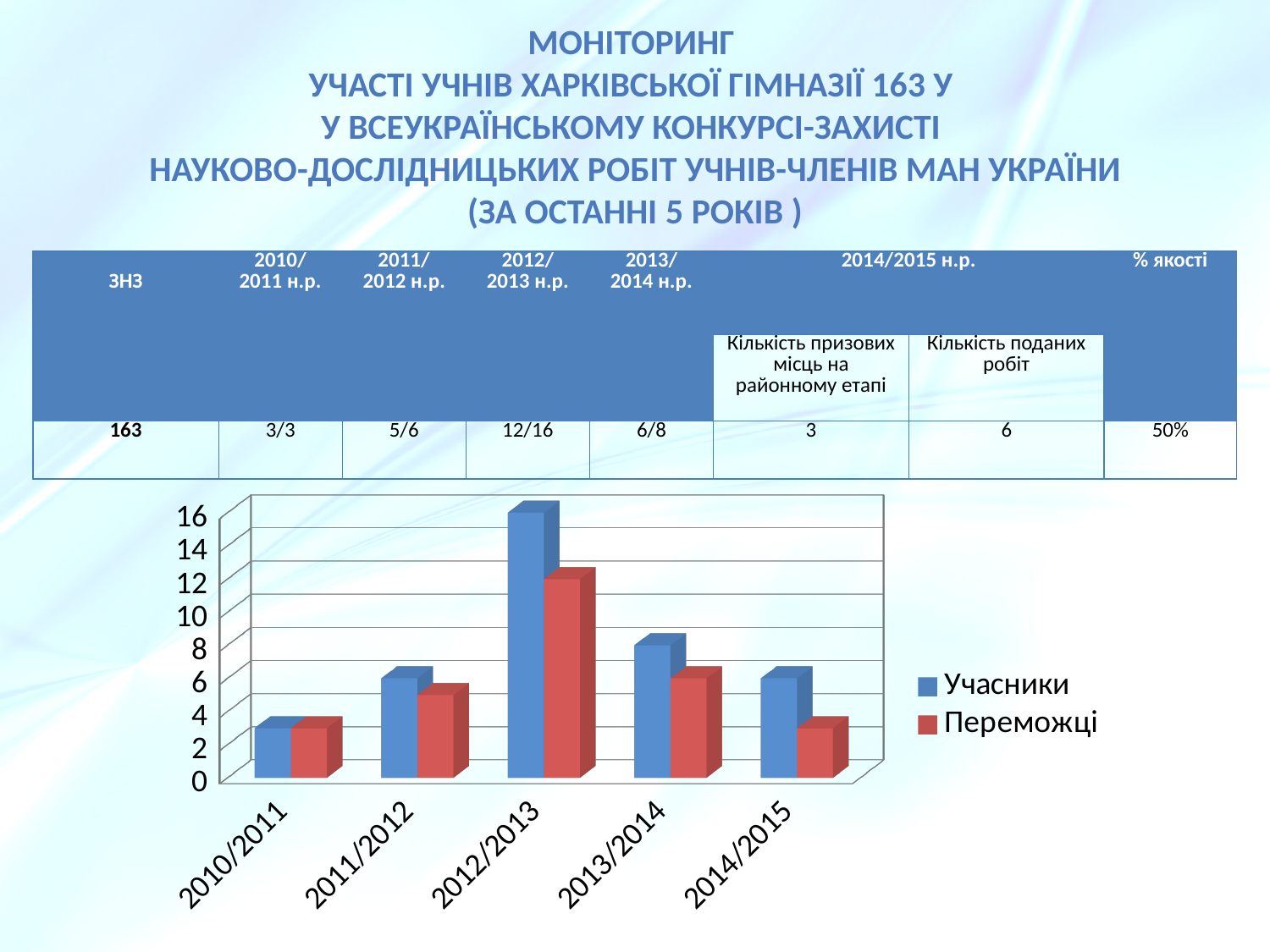
Which academic year has the lowest value for Учасники? 2010/2011 In 2013/2014, which is larger: Учасники or Переможці? Учасники What is the value for Переможці in 2012/2013? 12 How many academic years are shown on the x axis of the chart? 5 Which academic year has the highest value for Учасники? 2012/2013 What is the value for Учасники in 2012/2013? 16 Is the value for Переможці in 2014/2015 greater or less than 4? less How many series does the chart legend list? 2 Which academic year has the highest value for Переможці? 2012/2013 Do the values for Учасники rise or fall from 2012/2013 to 2014/2015? fall What kind of chart is shown on the slide? bar chart What is the difference between Учасники and Переможці in 2012/2013? 4